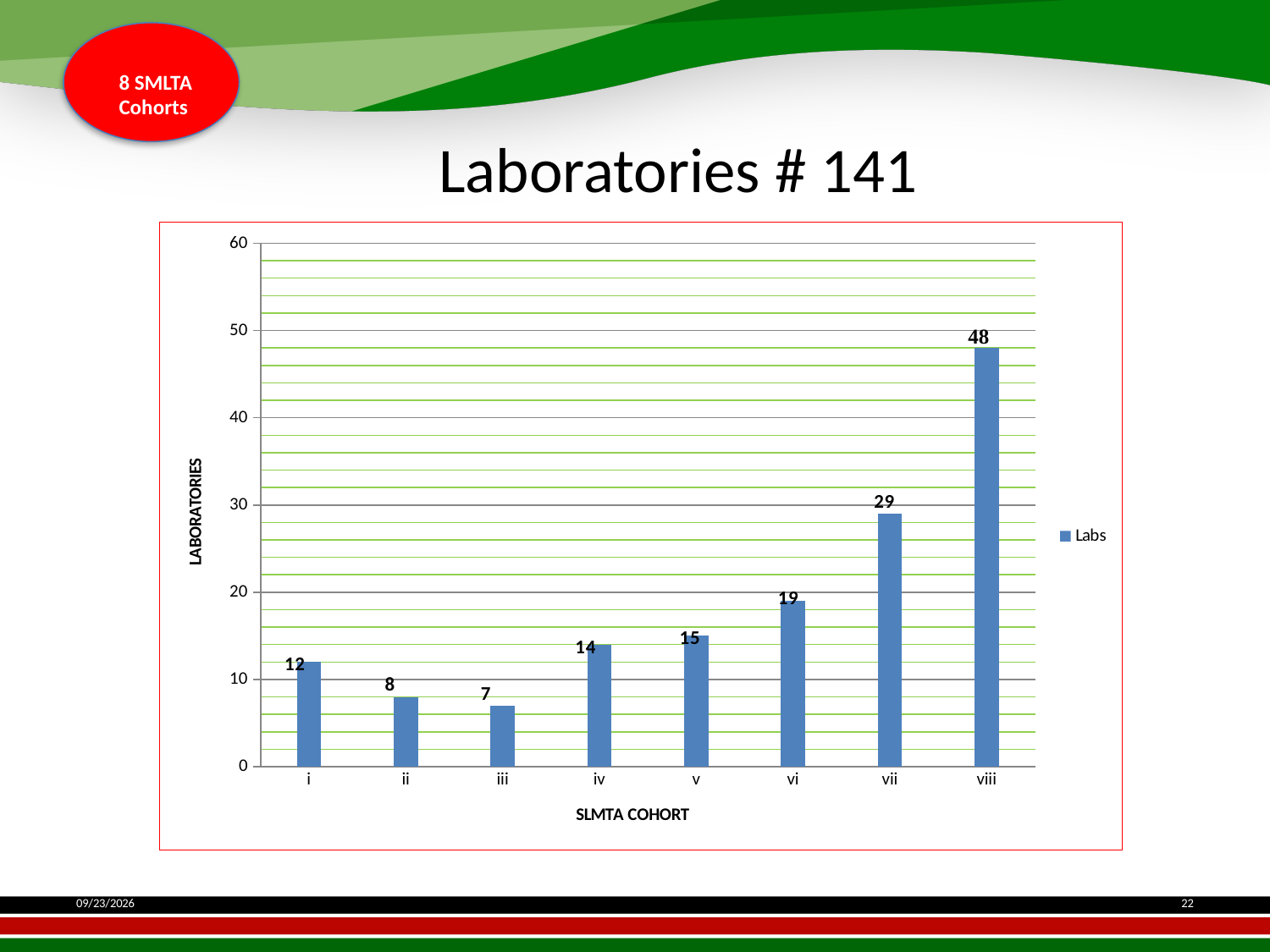
What is the number of laboratories for cohort iii? 7 Which SLMTA cohort has the lowest number of laboratories? iii What is the number of laboratories for cohort viii? 48 Which has more laboratories, cohort iv or cohort v? v How many series does the legend list? 1 Is the value for cohort vii greater or less than 20? greater Which SLMTA cohort has the highest number of laboratories? viii What is the difference in laboratories between cohort i and cohort ii? 4 What is the number of laboratories for cohort vi? 19 What type of chart is shown on the slide? bar chart What is the difference in laboratories between cohort viii and cohort vii? 19 How many SLMTA cohorts are shown on the x axis? 8